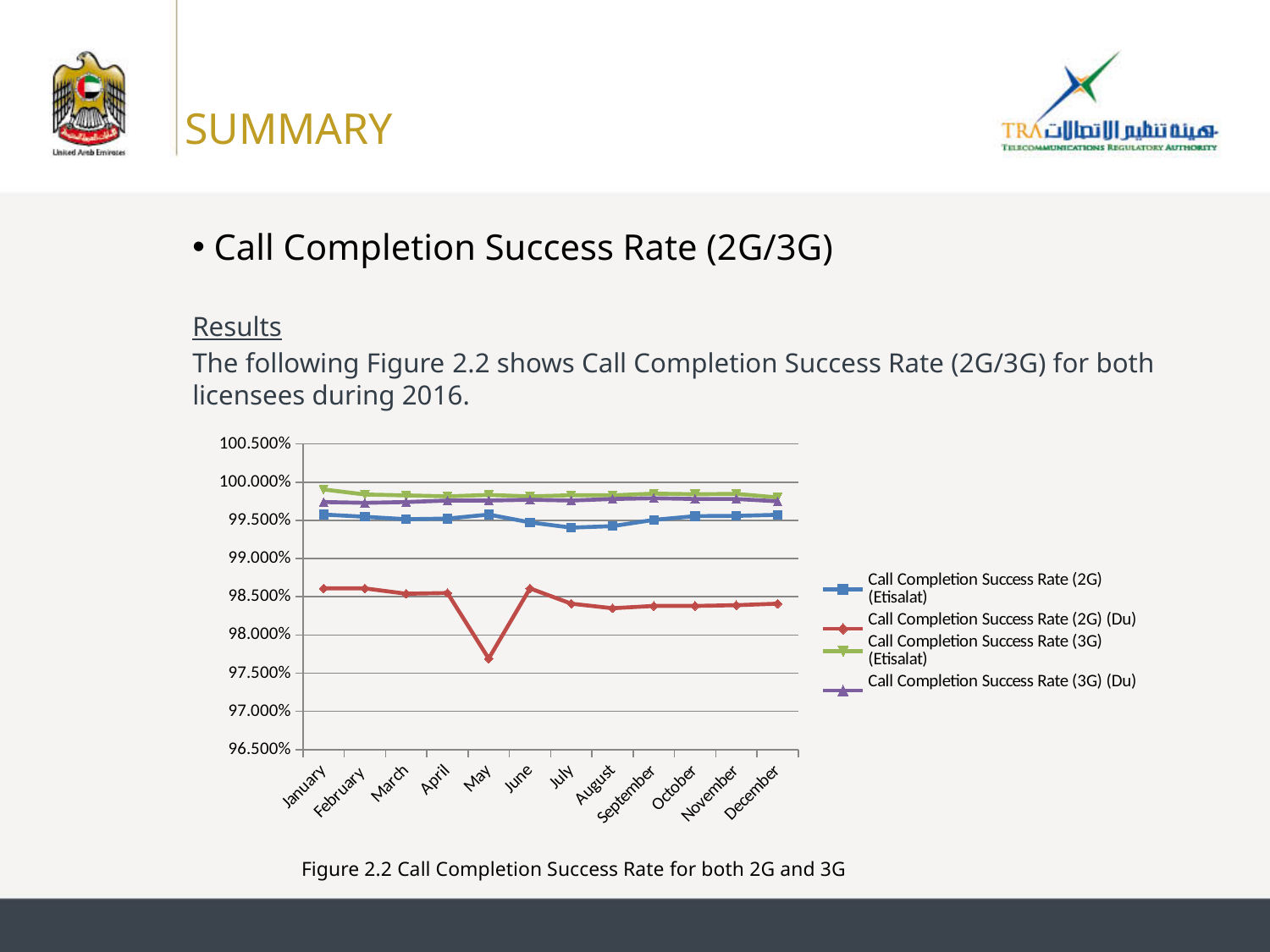
Is the Call Completion Success Rate (3G) (Etisalat) in January greater or less than 99.500%? greater Is the Call Completion Success Rate (2G) (Du) in January greater or less than 99.000%? less What is the caption given below the chart? Figure 2.2 Call Completion Success Rate for both 2G and 3G Which series has the lowest values across the year in the chart? Call Completion Success Rate (2G) (Du) In which month is the Call Completion Success Rate (2G) (Du) at its lowest? May Does the Call Completion Success Rate (2G) (Du) rise or fall from April to May? fall Which series has the highest value in January? Call Completion Success Rate (3G) (Etisalat) How many series does the chart legend list? 4 In January, which is larger: Call Completion Success Rate (3G) (Etisalat) or Call Completion Success Rate (2G) (Etisalat)? Call Completion Success Rate (3G) (Etisalat) How many months are plotted along the x axis of the chart? 12 Is the Call Completion Success Rate (2G) (Du) in May greater or less than 98.000%? less What kind of chart is shown on the slide? line chart